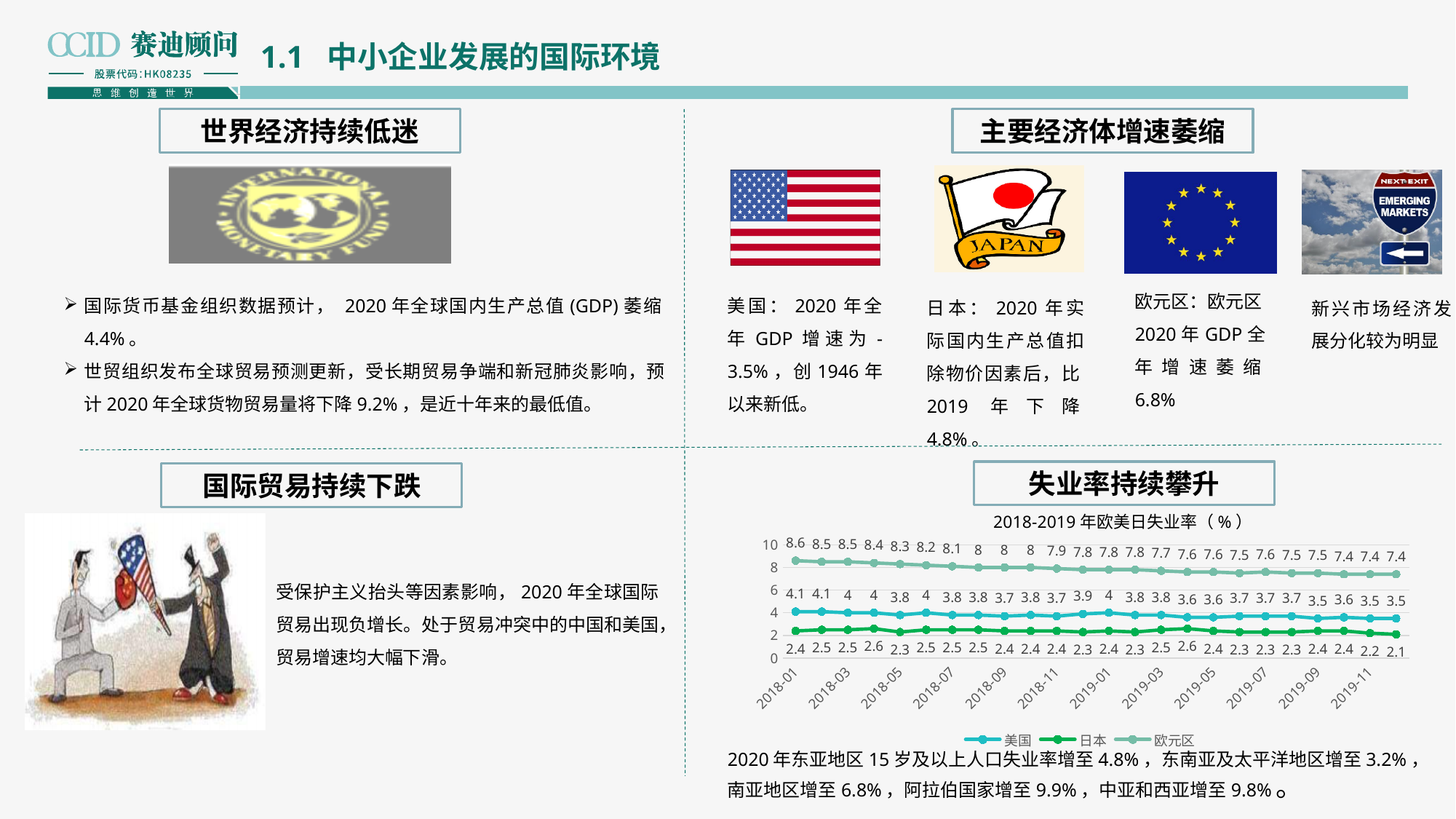
In the unemployment rate chart, what is the last plotted value for 日本 (at the end of 2019)? 2.1 In the unemployment rate chart, what is the lowest value plotted for 日本? 2.1 In the unemployment rate chart, what is the value for 日本 at 2018-01? 2.4 How many series does the legend of the unemployment rate chart list? 3 In the unemployment rate chart, what is the value for 美国 at 2018-01? 4.1 In the unemployment rate chart, what is the value for 欧元区 at 2018-01? 8.6 What kind of chart is shown under the heading 失业率持续攀升? line chart In the unemployment rate chart, which series has the highest values throughout the period: 美国, 日本 or 欧元区? 欧元区 What is the title of the line chart on the slide? 2018-2019年欧美日失业率（%） In the unemployment rate chart, what is the difference between the 欧元区 value at 2018-01 (8.6) and its last value at the end of 2019 (7.4)? 1.2 In the unemployment rate chart, what is the highest value plotted for 欧元区? 8.6 In the unemployment rate chart, does the 欧元区 line rise or fall from 2018-01 to the end of 2019? fall